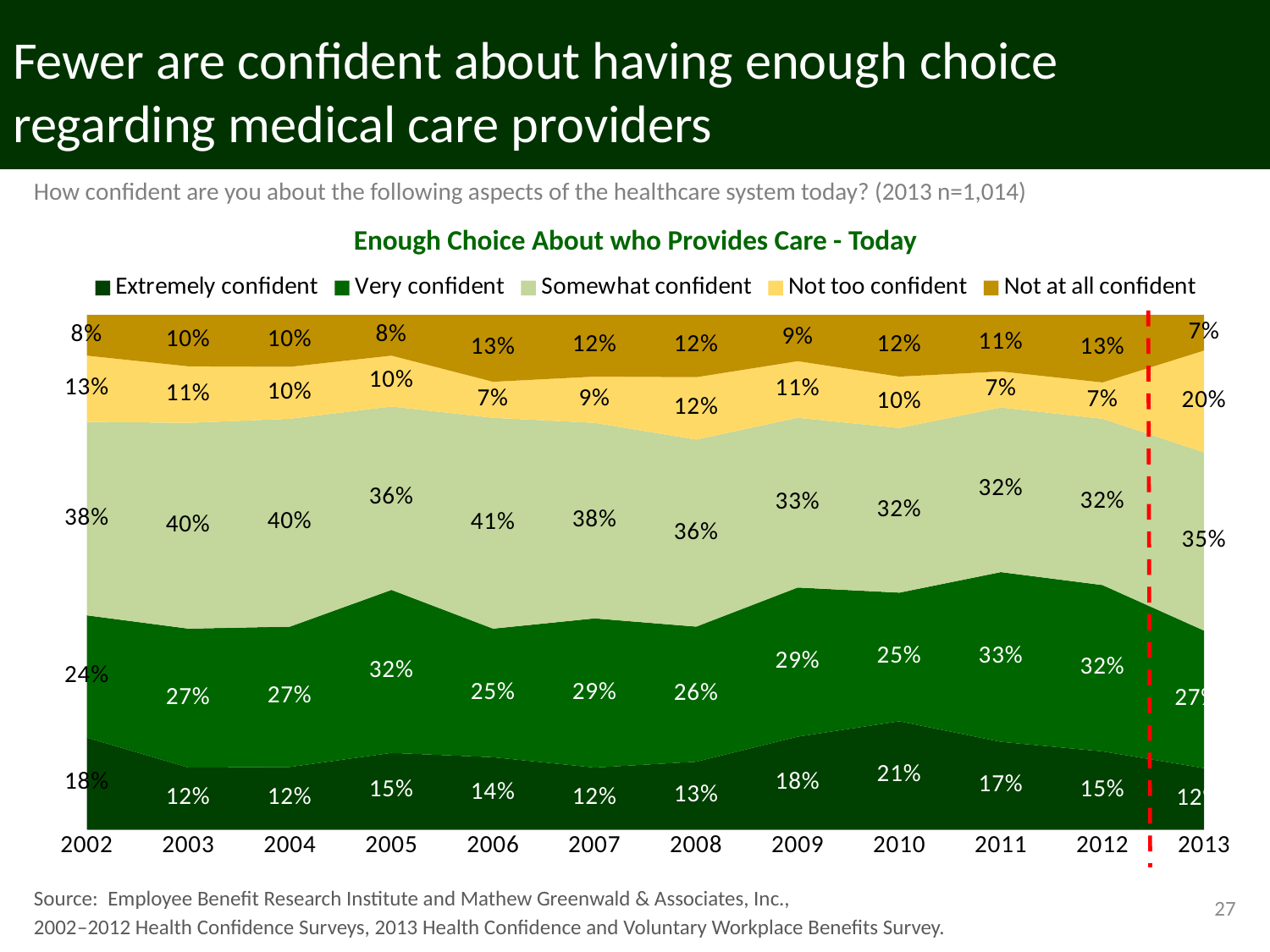
What is the value for Very confident in 2011? 33% How many years are shown along the x axis? 12 In which year is the Extremely confident value highest? 2010 What is the title of the chart? Enough Choice About who Provides Care - Today What is the value for Not too confident in 2013? 20% What is the value for Extremely confident in 2010? 21% Which is larger, the Very confident value in 2005 or in 2006? 2005 What type of chart is shown on the slide? Stacked area chart What is the difference between the Somewhat confident values in 2003 and 2009? 7% What is the value for Somewhat confident in 2006? 41% In which year is the Not at all confident value lowest? 2013 How many series does the legend list? 5